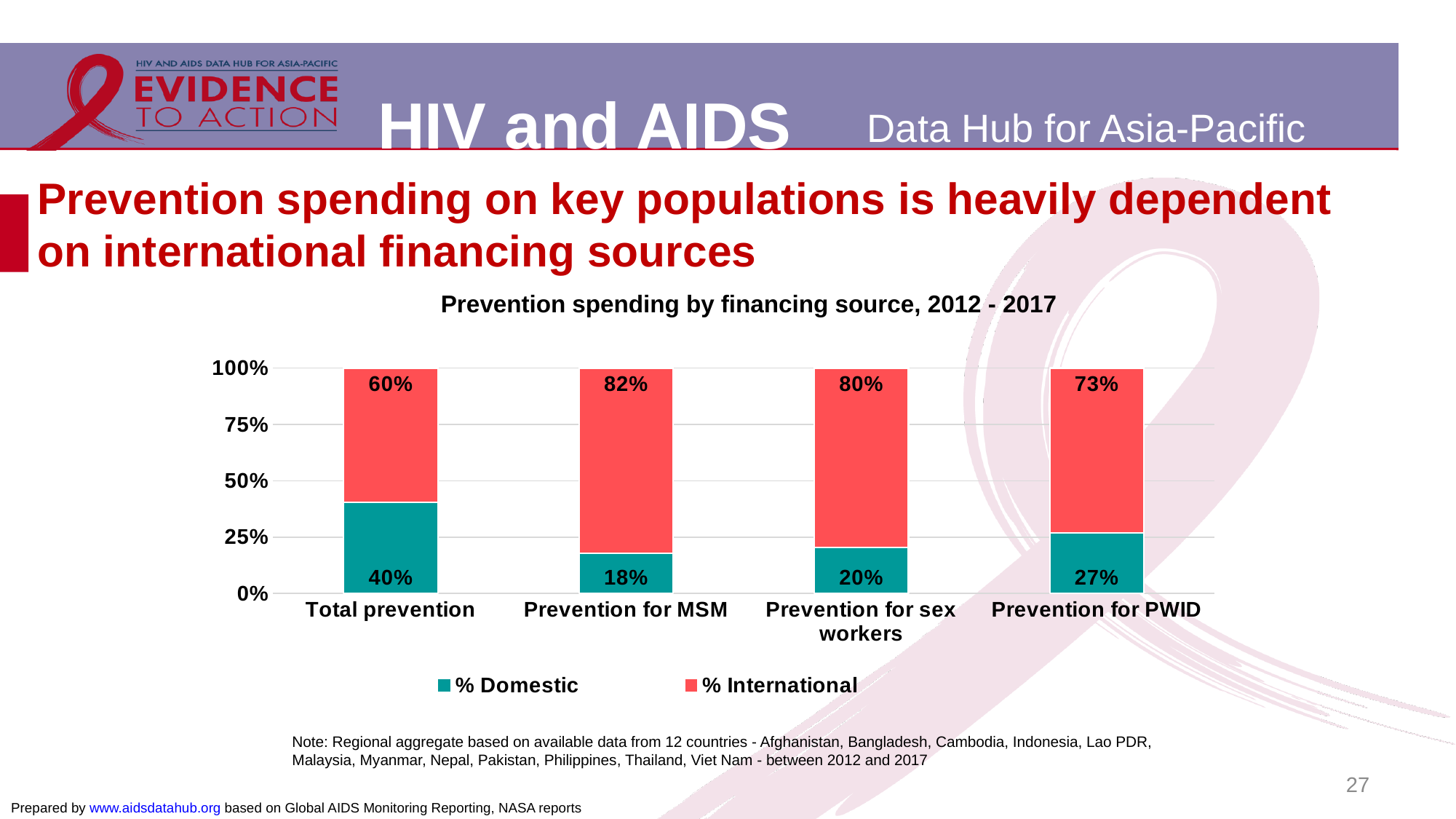
How many series does the legend list? 2 What kind of chart is shown on the slide? Stacked bar chart Is the % International value for Prevention for sex workers greater or less than 75%? greater Which category has the lowest % Domestic share? Prevention for MSM How many categories are shown on the x axis? 4 Which category has the highest % International share? Prevention for MSM What is the difference between the % International values for Prevention for MSM and Total prevention? 22% What is the % International value for Prevention for MSM? 82% What is the % Domestic value for Prevention for sex workers? 20% What is the % International value for Prevention for PWID? 73% What is the % Domestic value for Total prevention? 40% Which is larger: the % Domestic value for Prevention for PWID or for Prevention for sex workers? Prevention for PWID